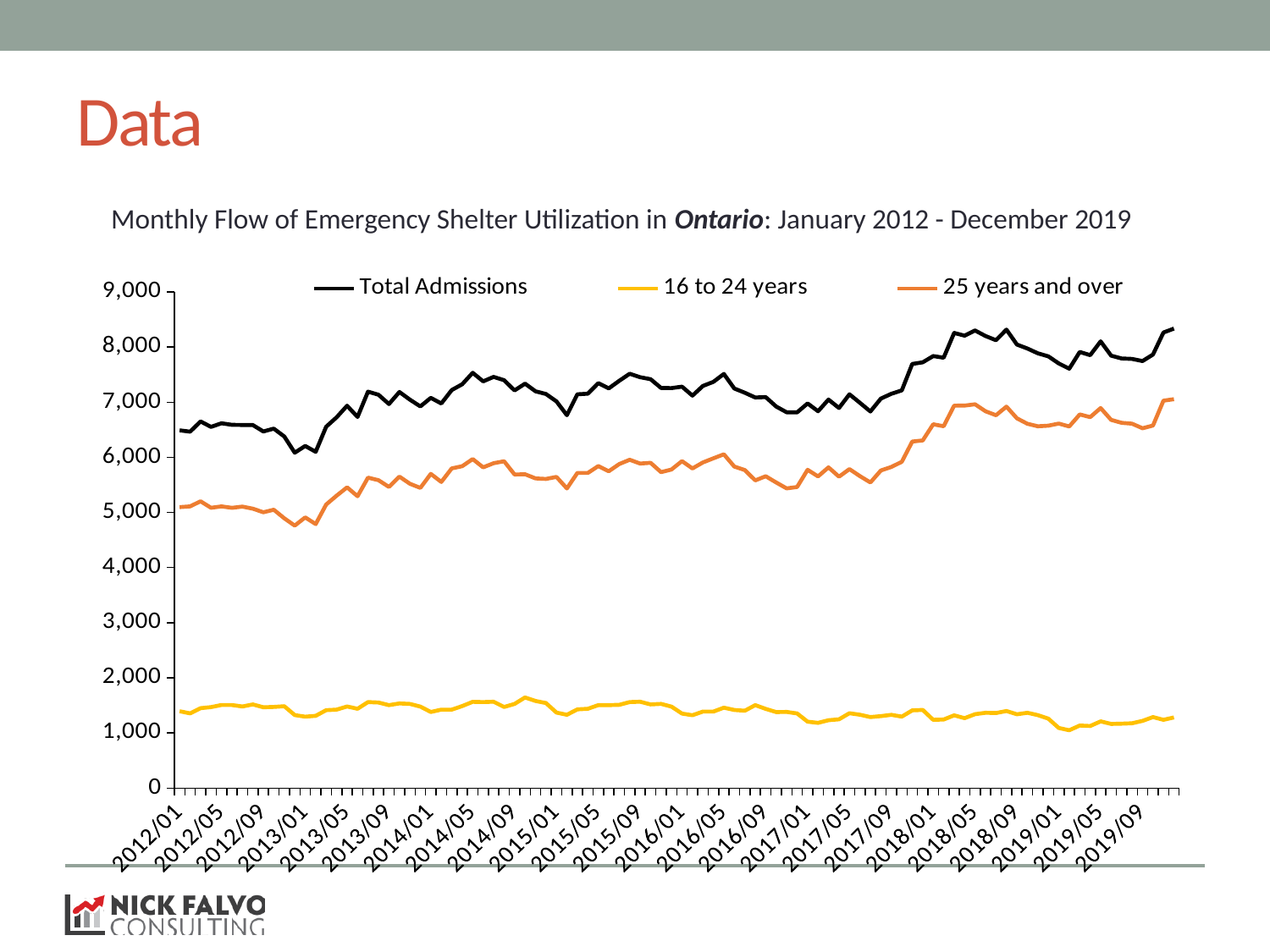
Is the value for Total Admissions at 2018/05 greater or less than 8,000? greater Which province does the chart title say the data is for? Ontario How many series does the legend list? 3 Does the Total Admissions series end higher or lower in 2019 than it started in 2012? Higher At 2018/05, which is larger: the value for 25 years and over or the value for 16 to 24 years? 25 years and over What are the three series named in the legend? Total Admissions, 16 to 24 years, 25 years and over Is the value for 16 to 24 years at 2019/01 greater or less than 2,000? less What kind of chart is shown on the slide? Line chart Is the value for Total Admissions at 2012/01 greater or less than 6,000? greater Which series has the highest values across the whole period? Total Admissions Which series has the lowest values across the whole period? 16 to 24 years